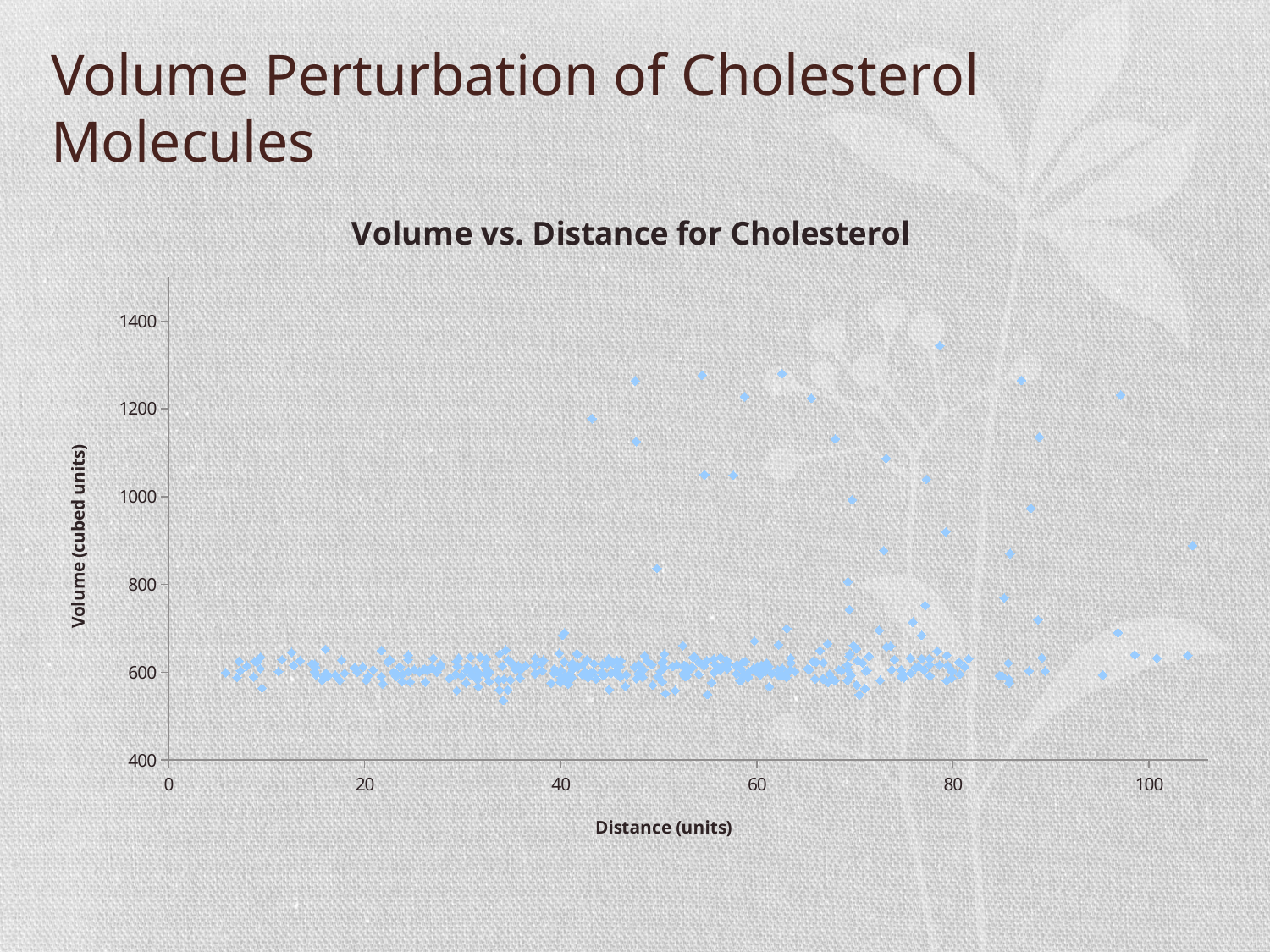
Along the distance axis, does the main cluster of volume values rise, fall, or stay roughly flat? roughly flat Do the points with volumes above 1000 appear at distances greater or less than 40? greater Are the majority of the plotted points above or below 800 on the volume axis? below Is the highest plotted volume value greater or less than 1200? greater What is the title of the chart? Volume vs. Distance for Cholesterol What kind of chart is shown on the slide? scatter chart What is the label of the y axis? Volume (cubed units)